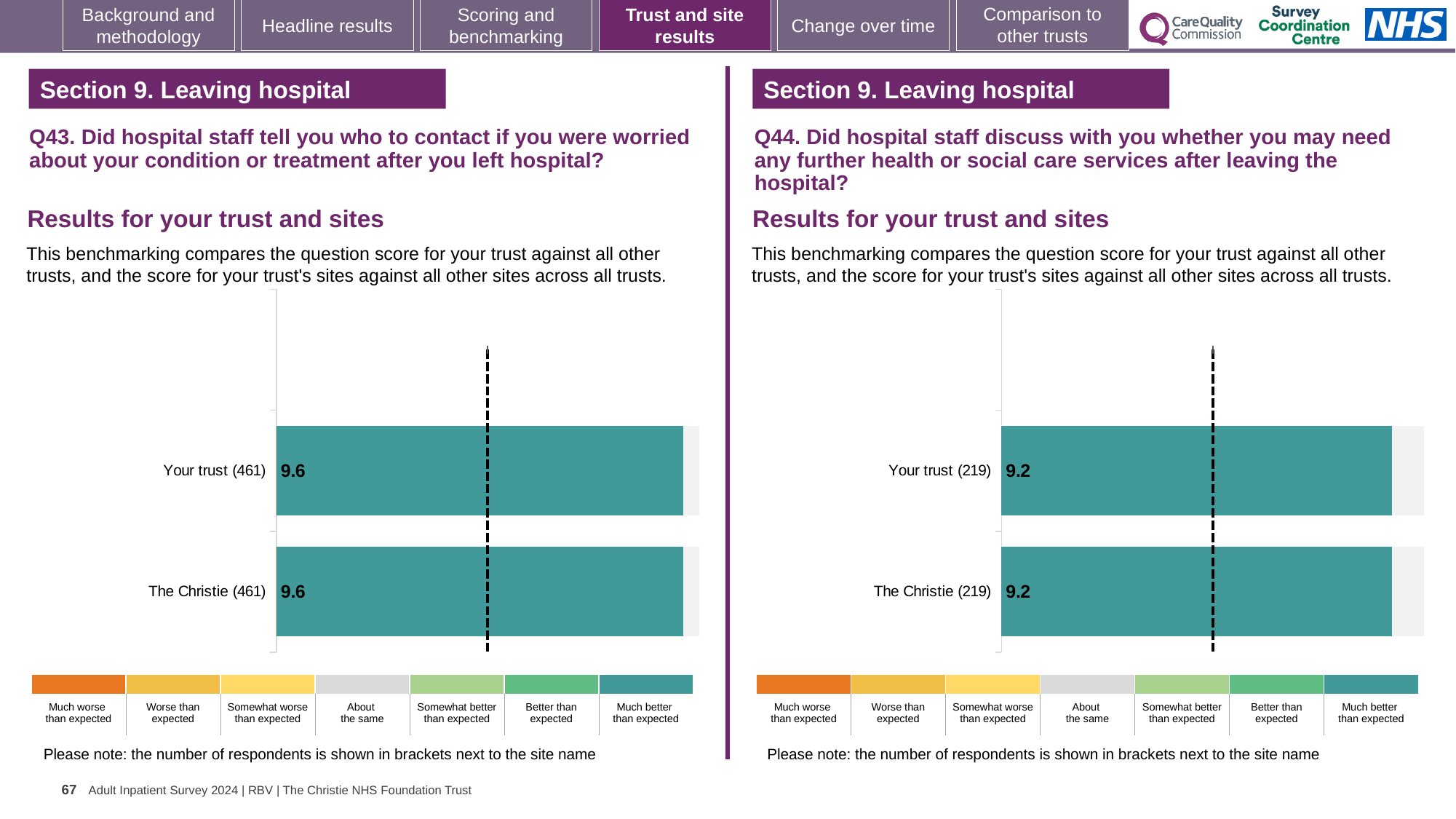
In the Q43 chart on the left, what is the score for Your trust? 9.6 In the Q44 chart on the right, what is the score for The Christie? 9.2 How many bars are plotted in the Q44 chart on the right? 2 In the Q44 chart on the right, what is the score for Your trust? 9.2 In the Q43 chart on the left, how many respondents are shown in brackets for Your trust? 461 What kind of chart is used for the Q43 results on the left? Bar chart In the Q44 chart on the right, how many respondents are shown in brackets for The Christie? 219 How many bars are plotted in the Q43 chart on the left? 2 In the Q44 chart on the right, what is the difference between the scores for Your trust and The Christie? 0 In the Q43 chart on the left, what is the score for The Christie? 9.6 In the Q44 chart on the right, which benchmark category does the colour of the bars correspond to in the key below? Much better than expected In the Q43 chart on the left, what is the difference between the scores for Your trust and The Christie? 0